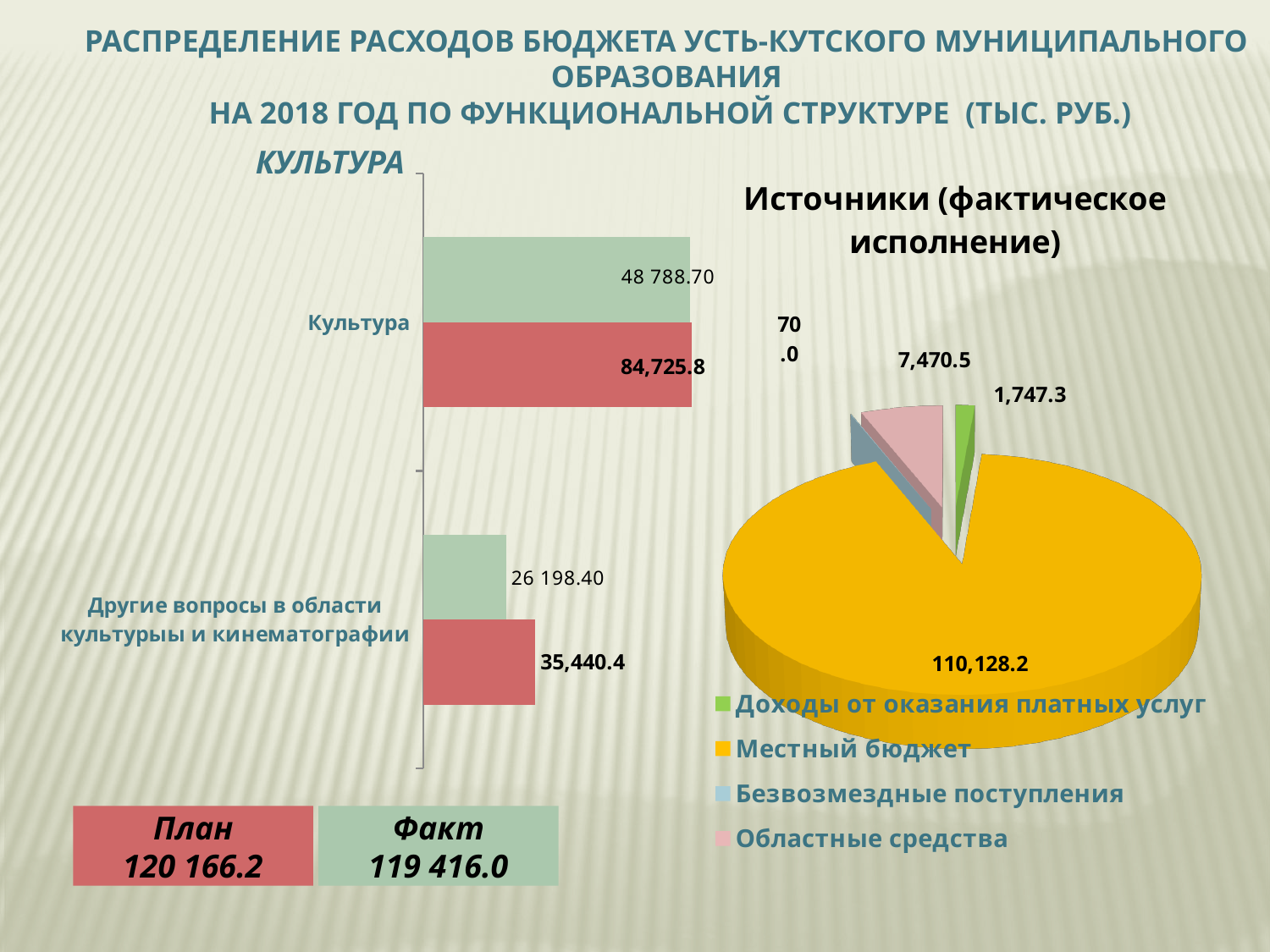
In the pie chart titled Источники (фактическое исполнение), which source has the largest slice? Местный бюджет In the bar chart titled КУЛЬТУРА, what is the value of the red (План) bar for Культура? 84,725.8 In the bar chart titled КУЛЬТУРА, what is the value of the red (План) bar for Другие вопросы в области культуры и кинематографии? 35,440.4 In the bar chart titled КУЛЬТУРА, what is the value of the green (Факт) bar for Другие вопросы в области культуры и кинематографии? 26 198.40 In the pie chart titled Источники (фактическое исполнение), what is the value for Местный бюджет? 110,128.2 In the bar chart titled КУЛЬТУРА, what is the difference between the red (План) bars for Культура and Другие вопросы в области культуры и кинематографии? 49,285.4 In the bar chart titled КУЛЬТУРА, what is the value of the green (Факт) bar for Культура? 48 788.70 In the pie chart titled Источники (фактическое исполнение), what is the value for Областные средства? 7,470.5 How many categories are shown in the bar chart titled КУЛЬТУРА? 2 How many entries does the legend of the pie chart titled Источники (фактическое исполнение) list? 4 In the bar chart titled КУЛЬТУРА, which category has the larger red (План) bar: Культура or Другие вопросы в области культуры и кинематографии? Культура What kind of chart is the chart titled КУЛЬТУРА on the left of the slide? bar chart